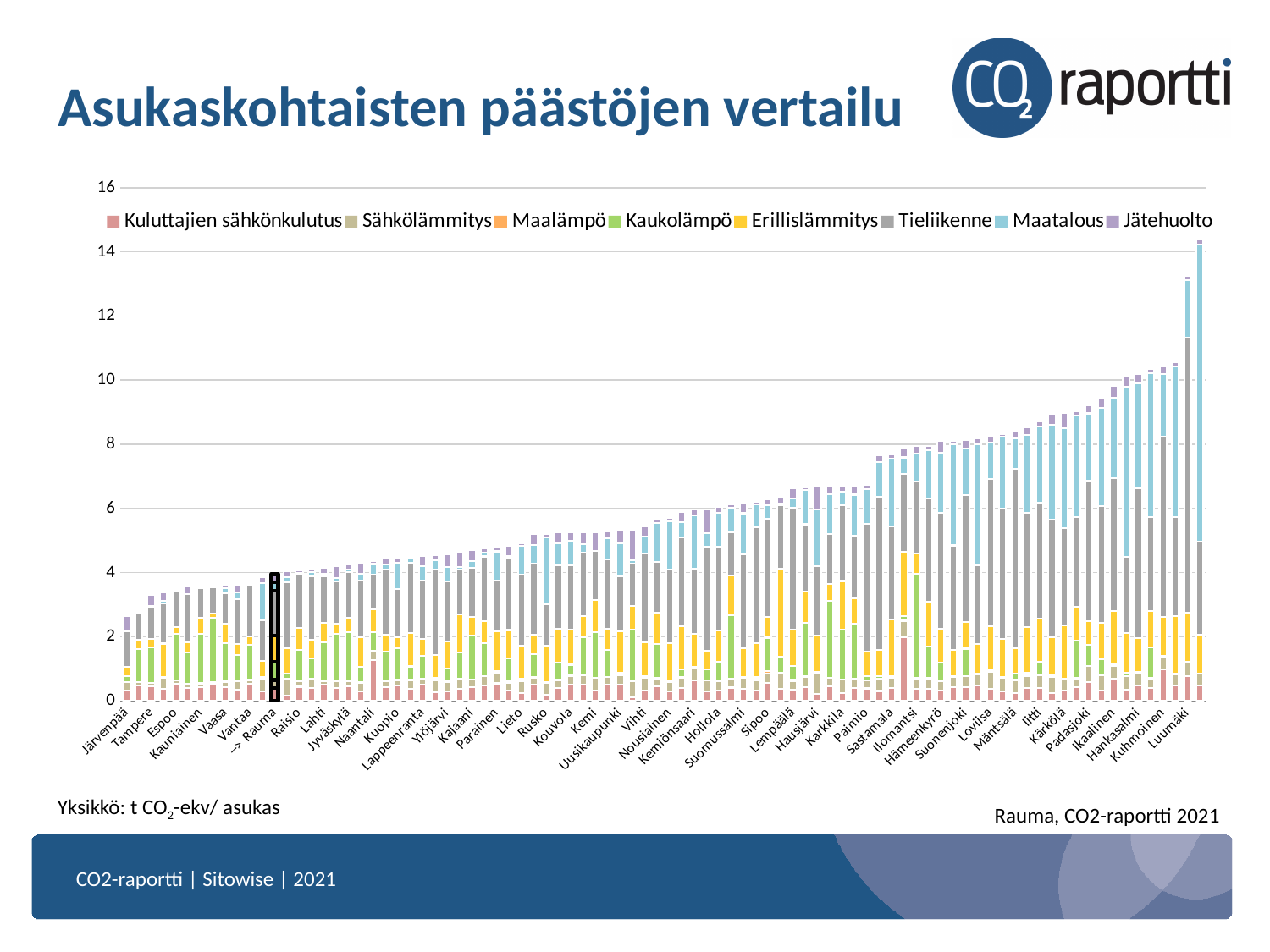
Which has a larger total, Luumäki or Järvenpää? Luumäki How many series does the legend list? 8 Is the total value for Ilomantsi greater or less than 6? greater Which municipality has the lowest total per-capita emissions? Järvenpää Do the total bar heights rise or fall from left to right along the x axis? rise Is the total value for Järvenpää greater or less than 4? less Which municipality's bar is outlined in black on the chart? Rauma What kind of chart is shown on the slide? stacked bar chart Is the total value for Luumäki greater or less than 12? greater What is the title of the chart? Asukaskohtaisten päästöjen vertailu